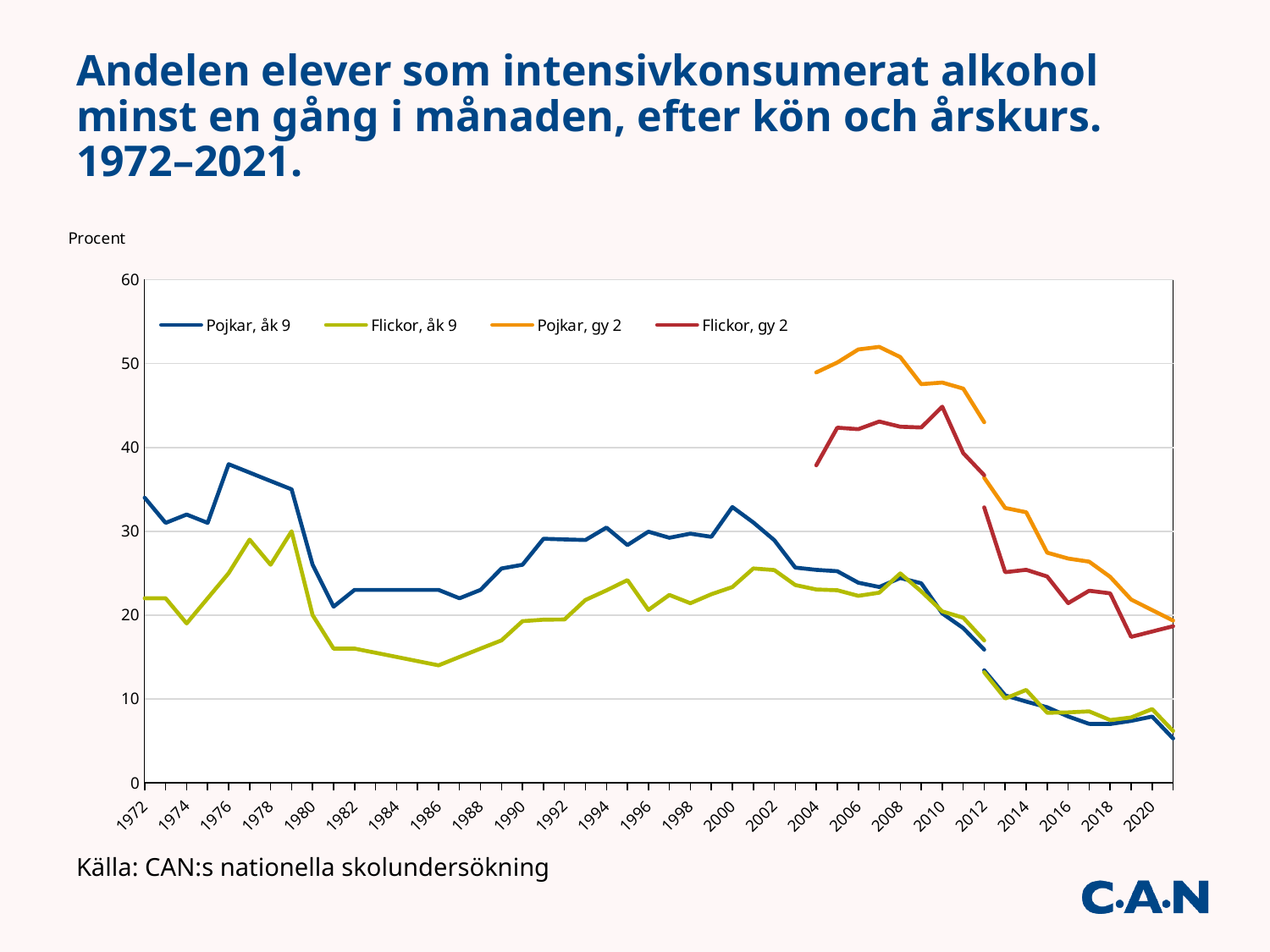
Is the value for Flickor, gy 2 in 2016 greater or less than 30? less In 2007, which series has the higher value: Pojkar, gy 2 or Flickor, gy 2? Pojkar, gy 2 What is the label on the vertical axis? Procent How many series does the legend list? 4 Which series reaches the highest value anywhere on the chart? Pojkar, gy 2 Is the value for Pojkar, gy 2 in 2007 greater or less than 50? greater Is the value for Pojkar, åk 9 in 1976 greater or less than 30? greater What are the four series named in the legend? Pojkar, åk 9; Flickor, åk 9; Pojkar, gy 2; Flickor, gy 2 In 2000, which series has the higher value: Pojkar, åk 9 or Flickor, åk 9? Pojkar, åk 9 What kind of chart is shown on the slide? line chart Does the Pojkar, gy 2 line rise or fall from 2012 to 2021? fall